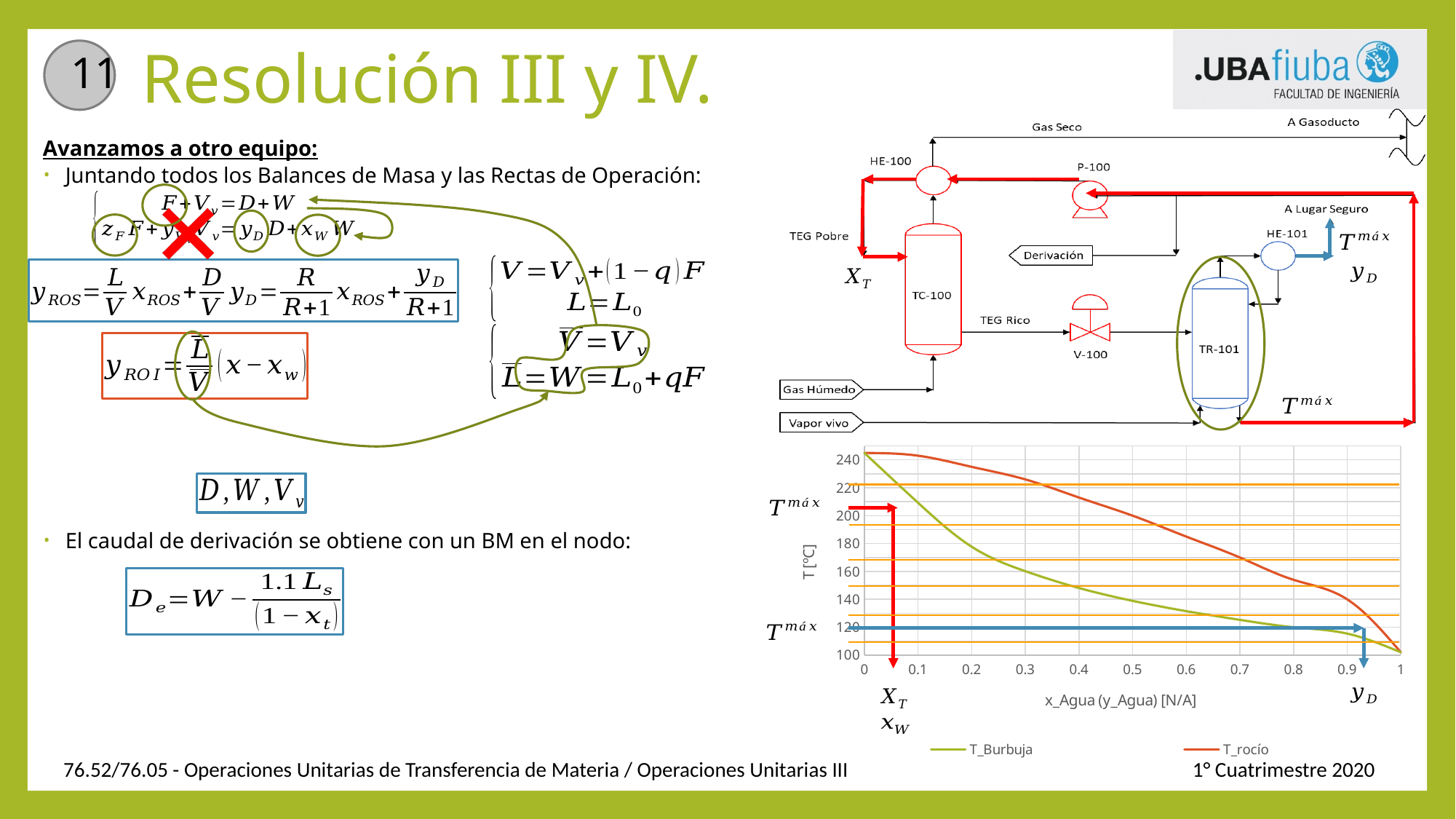
In the chart at the bottom right, is the T_Burbuja value at x_Agua = 0.7 greater or less than 160? less What are the two series named in the legend of the chart at the bottom right? T_Burbuja and T_rocío In the chart at the bottom right, which series is drawn in red? T_rocío How many series does the legend of the T [°C] vs x_Agua chart list? 2 What kind of chart is shown at the bottom right of the slide? line chart In the chart at the bottom right, is the T_rocío value at x_Agua = 0.2 greater or less than 200? greater In the chart at the bottom right, is the T_rocío value at x_Agua = 0.5 greater or less than 180? greater What is the label of the vertical axis of the chart at the bottom right? T [°C] In the chart at the bottom right, does the T_rocío curve rise or fall as x_Agua increases? fall In the chart at the bottom right, at x_Agua = 0.5, which series has the higher temperature, T_Burbuja or T_rocío? T_rocío In the chart at the bottom right, does the T_Burbuja curve rise or fall as x_Agua increases from 0 to 1? fall